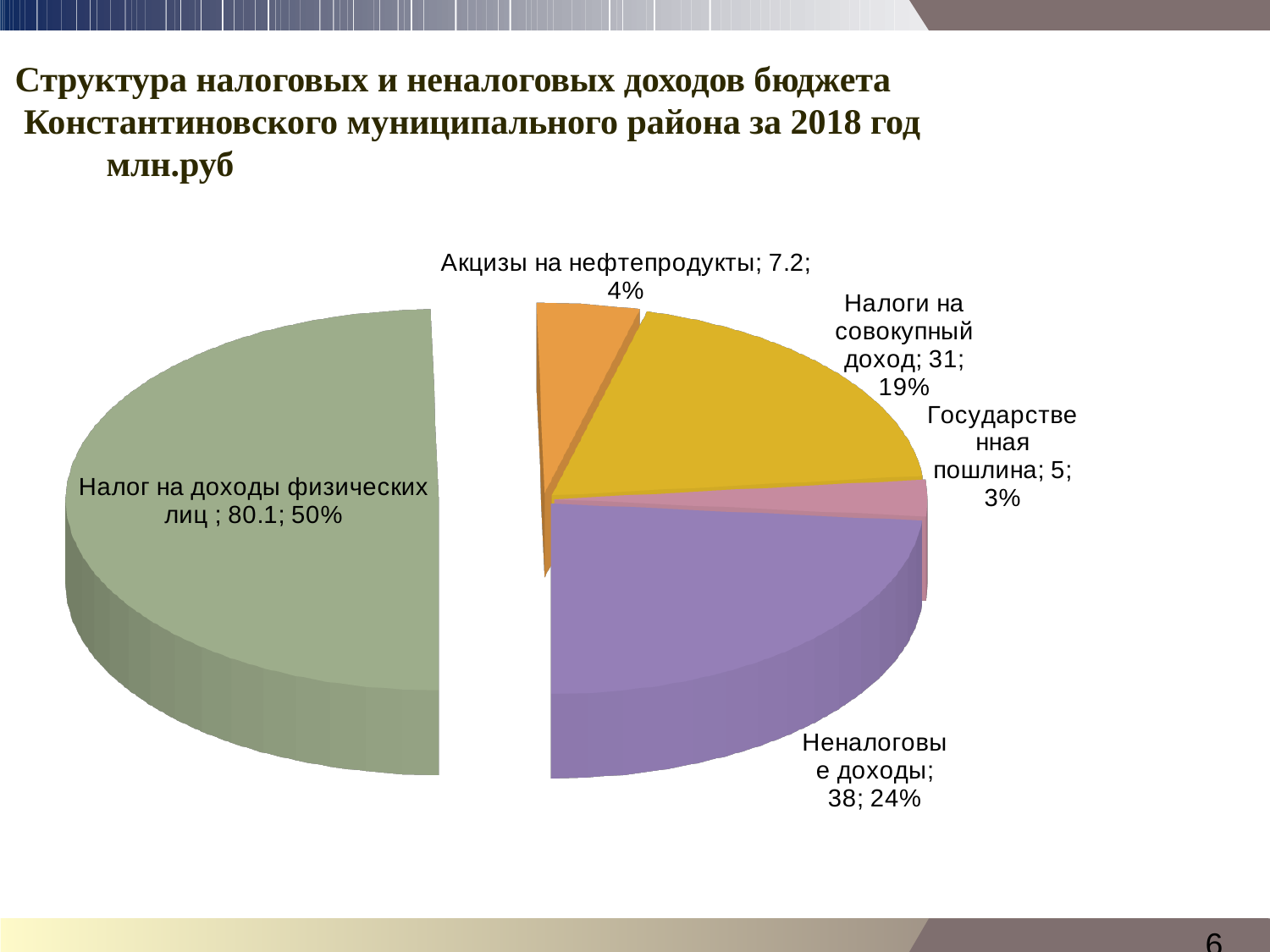
What is the value for Налоги на совокупный доход? 31 Which is larger, the value for Акцизы на нефтепродукты or Государственная пошлина? Акцизы на нефтепродукты Which category has the largest slice? Налог на доходы физических лиц What share of the pie does Государственная пошлина represent? 3% What share of the pie does Неналоговые доходы represent? 24% What is the difference between the values for Неналоговые доходы and Налоги на совокупный доход? 7 What is the value for Неналоговые доходы? 38 How many slices does the pie chart have? 5 What is the value for Акцизы на нефтепродукты? 7.2 What is the value for Налог на доходы физических лиц? 80.1 Which category has the smallest slice? Государственная пошлина What kind of chart is shown on the slide? pie chart